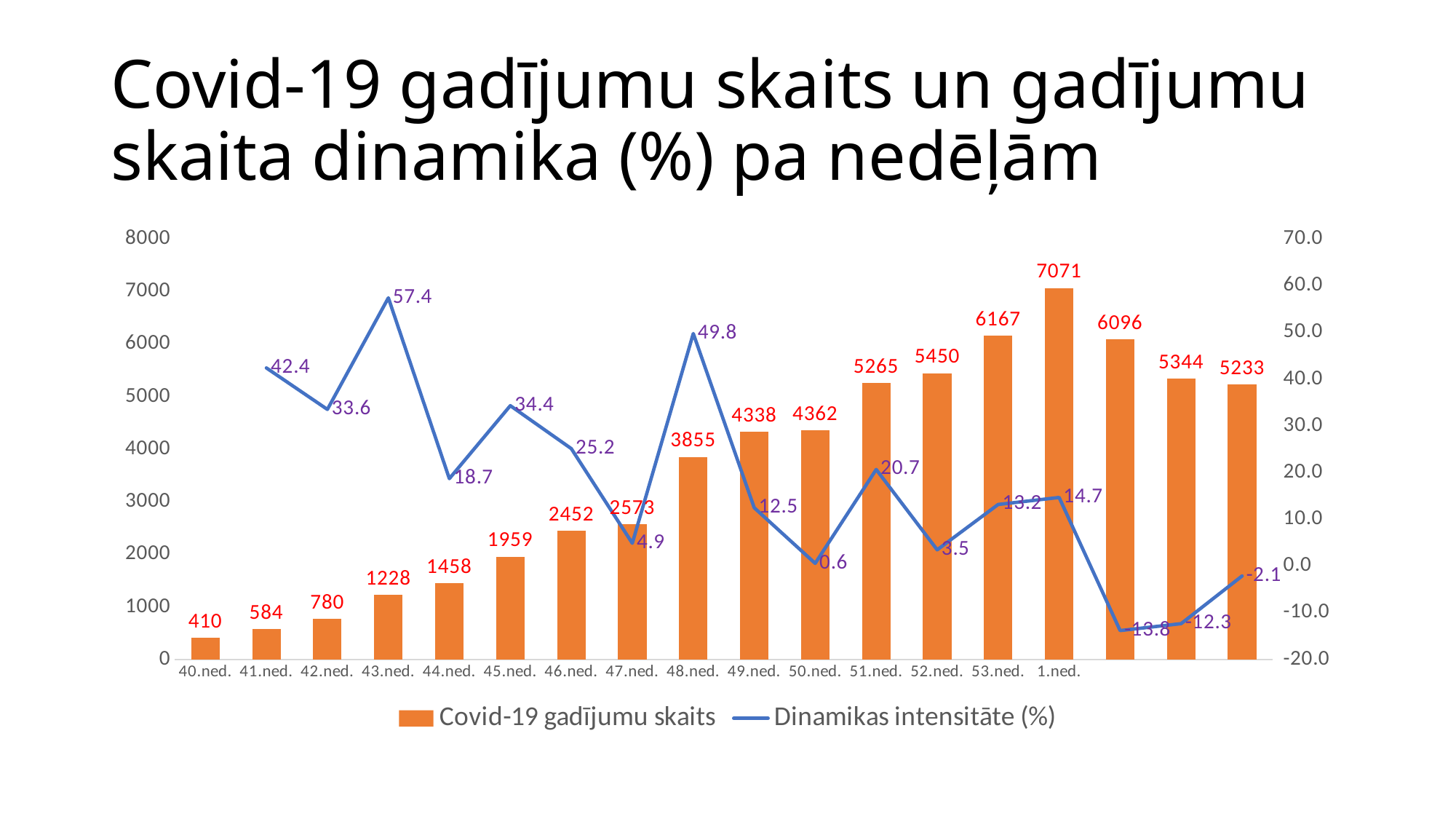
How many series does the legend list? 2 Which week has the lowest Covid-19 gadījumu skaits? 40.ned. Which week has the highest Dinamikas intensitāte (%)? 43.ned. What is the difference in Covid-19 gadījumu skaits between 1.ned. and 53.ned.? 904 Which is larger, the Covid-19 gadījumu skaits for 49.ned. or for 50.ned.? 50.ned. What kind of chart is shown on the slide? Combined bar and line chart Which week has the highest Covid-19 gadījumu skaits? 1.ned. What is the Dinamikas intensitāte (%) value for 43.ned.? 57.4 What is the Covid-19 gadījumu skaits value for 45.ned.? 1959 Does the Covid-19 gadījumu skaits rise or fall from 40.ned. to 1.ned.? rise What is the Dinamikas intensitāte (%) value for 50.ned.? 0.6 Is the Covid-19 gadījumu skaits for 48.ned. greater or less than 4000? less